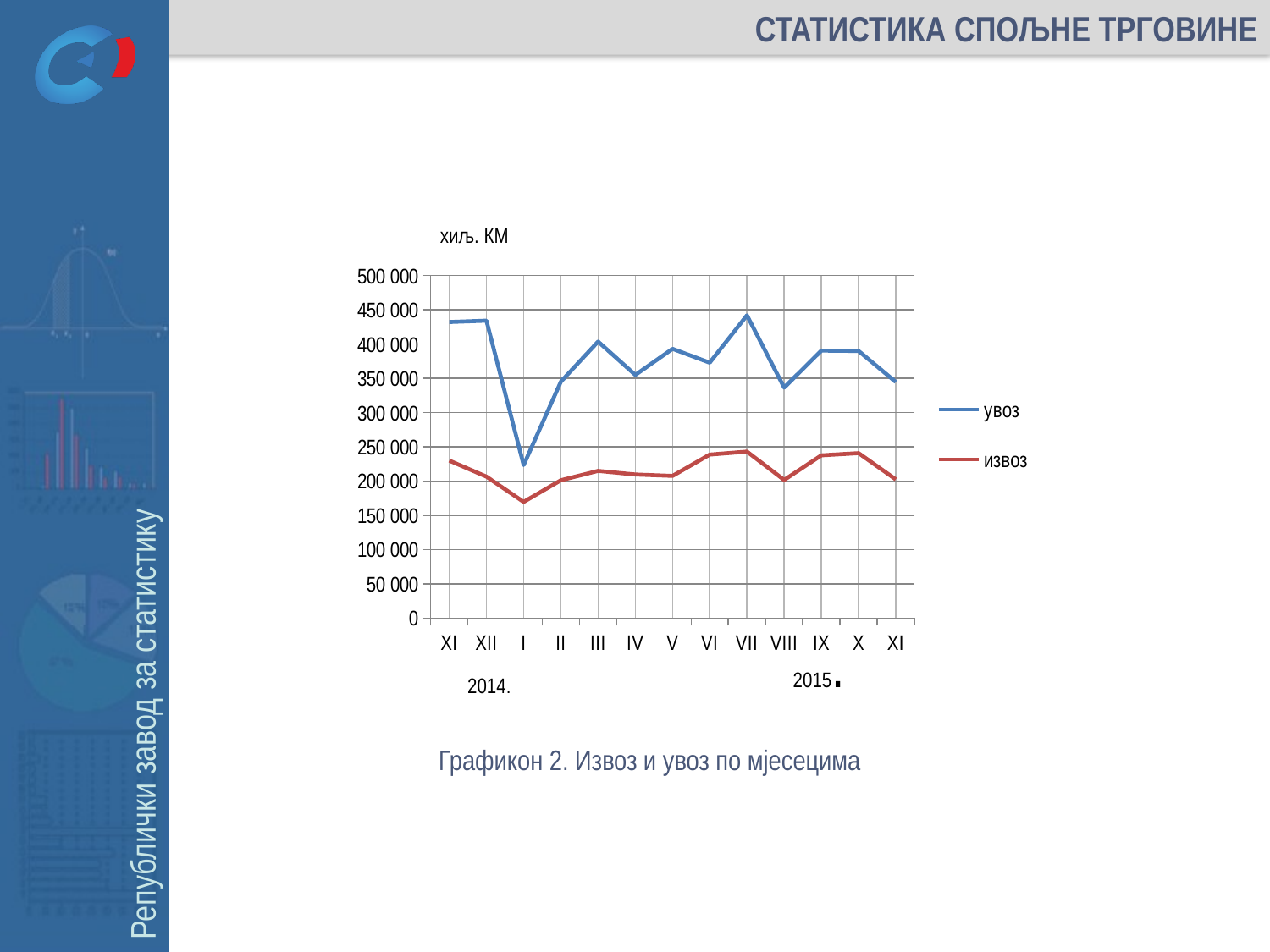
Is the value for увоз in month VII greater or less than 400 000? greater Which series has the larger value in month VII, увоз or извоз? увоз What kind of chart is shown on the slide? line chart Is the value for извоз in month I greater or less than 200 000? less Does the value for увоз rise or fall from month XII to month I? fall How many series does the legend list? 2 What are the two series named in the legend? увоз and извоз In which month is the value for увоз lowest? I How many months are plotted along the x axis? 13 Is the value for увоз in month I greater or less than 250 000? less What unit is stated above the y axis? хиљ. КМ In which month is the value for извоз lowest? I